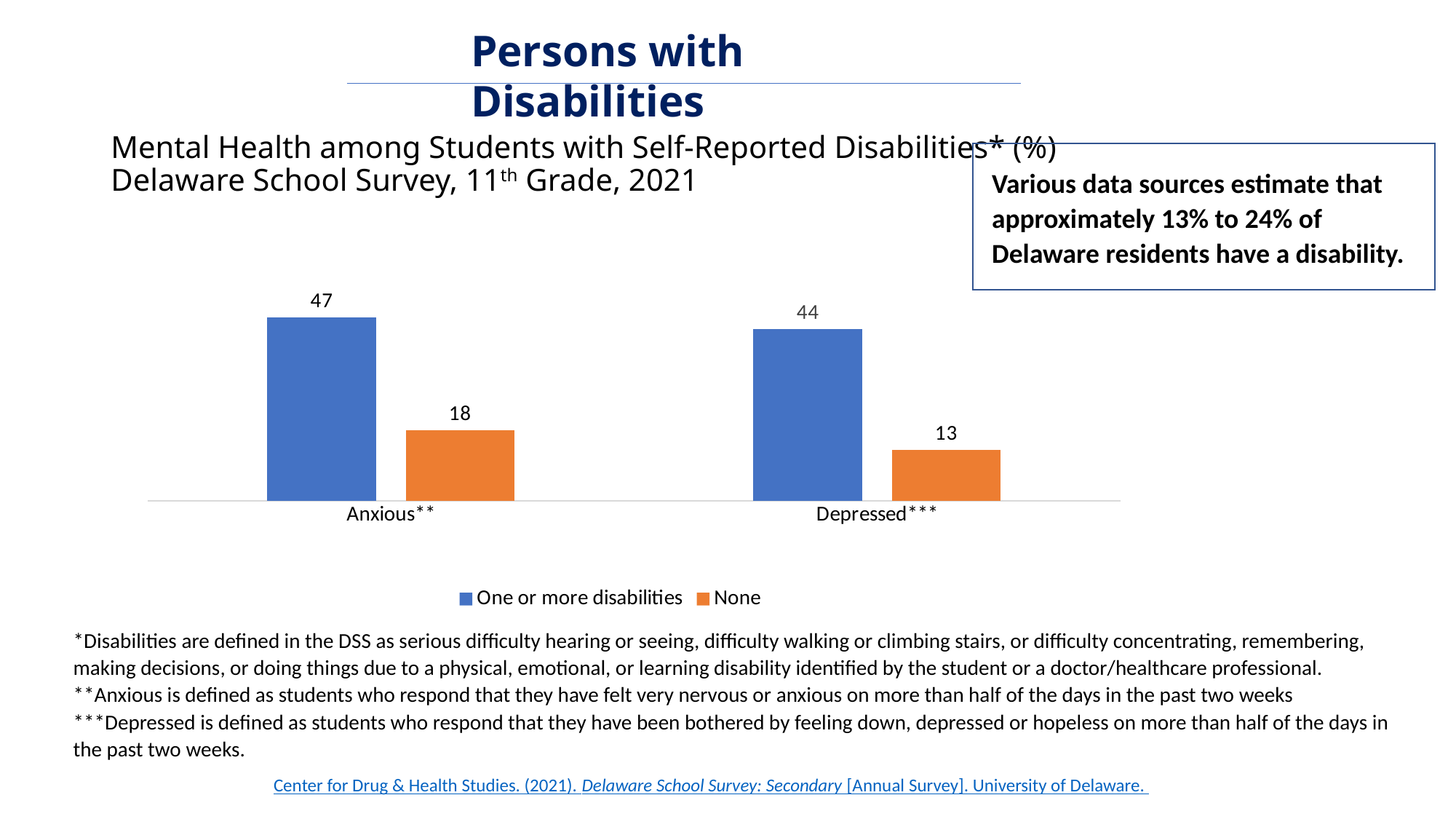
What is the value for 'None' in the Depressed category? 13 What is the difference between the 'One or more disabilities' and 'None' values in the Depressed category? 31 What is the value for 'None' in the Anxious category? 18 Which bar has the highest value on the chart? One or more disabilities, Anxious What is the value for 'One or more disabilities' in the Anxious category? 47 What is the difference between the 'One or more disabilities' and 'None' values in the Anxious category? 29 Which bar has the lowest value on the chart? None, Depressed What is the value for 'One or more disabilities' in the Depressed category? 44 How many categories are shown on the x axis? 2 How many series does the legend list? 2 What kind of chart is shown on the slide? Bar chart Which is larger: the 'None' value for Anxious or the 'None' value for Depressed? Anxious